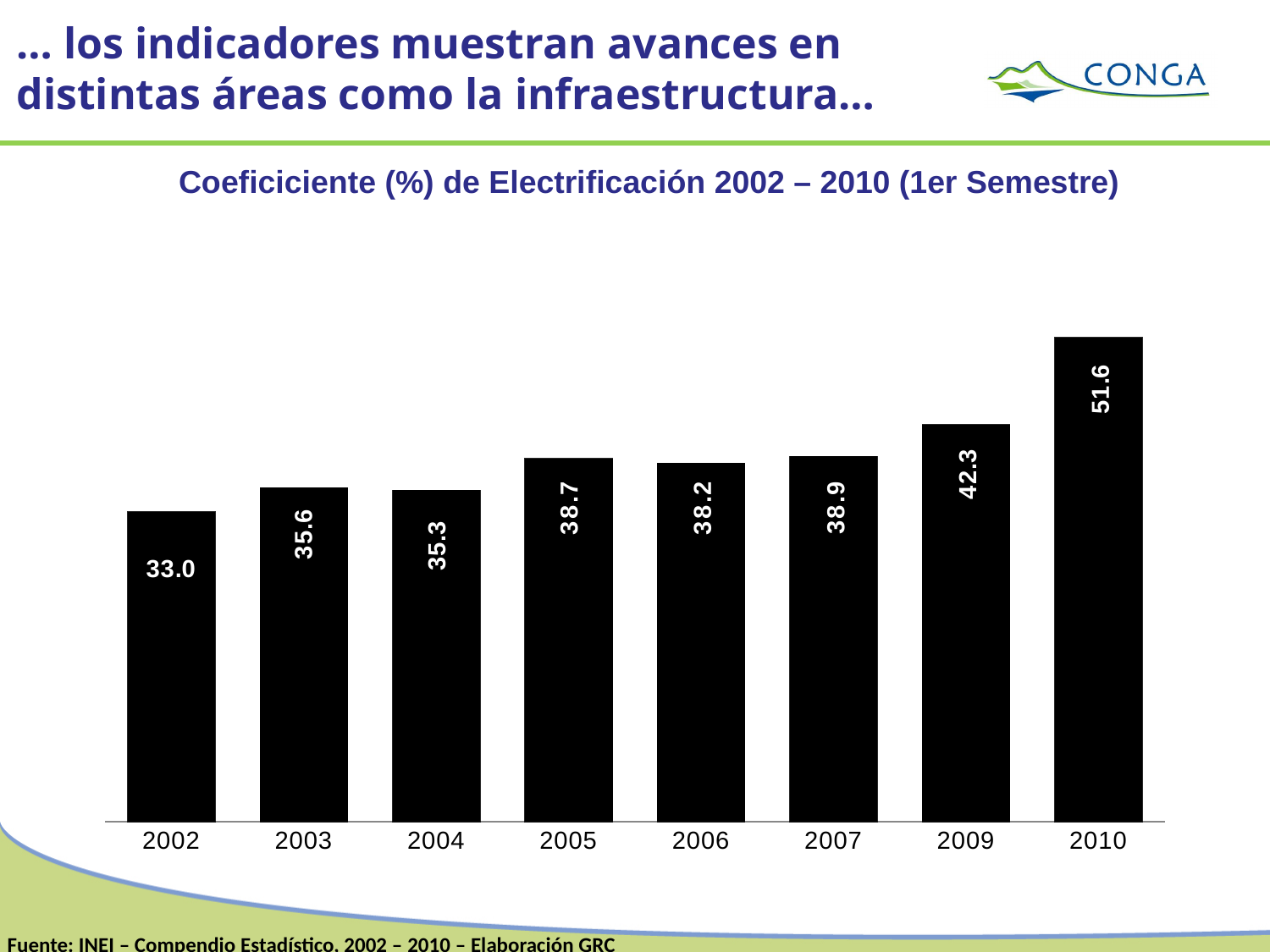
Which year has the lowest electrification coefficient? 2002 Which year has a higher electrification coefficient, 2005 or 2006? 2005 What is the electrification coefficient for 2009? 42.3 What is the electrification coefficient for 2002? 33.0 What is the electrification coefficient for 2006? 38.2 What is the title of the chart? Coeficiciente (%) de Electrificación 2002 – 2010 (1er Semestre) What is the difference between the electrification coefficient in 2010 and in 2002? 18.6 Which year has a higher electrification coefficient, 2003 or 2004? 2003 Which year has the highest electrification coefficient? 2010 What is the difference between the electrification coefficient in 2009 and in 2007? 3.4 What kind of chart is shown on the slide? Bar chart How many years are shown on the chart? 8